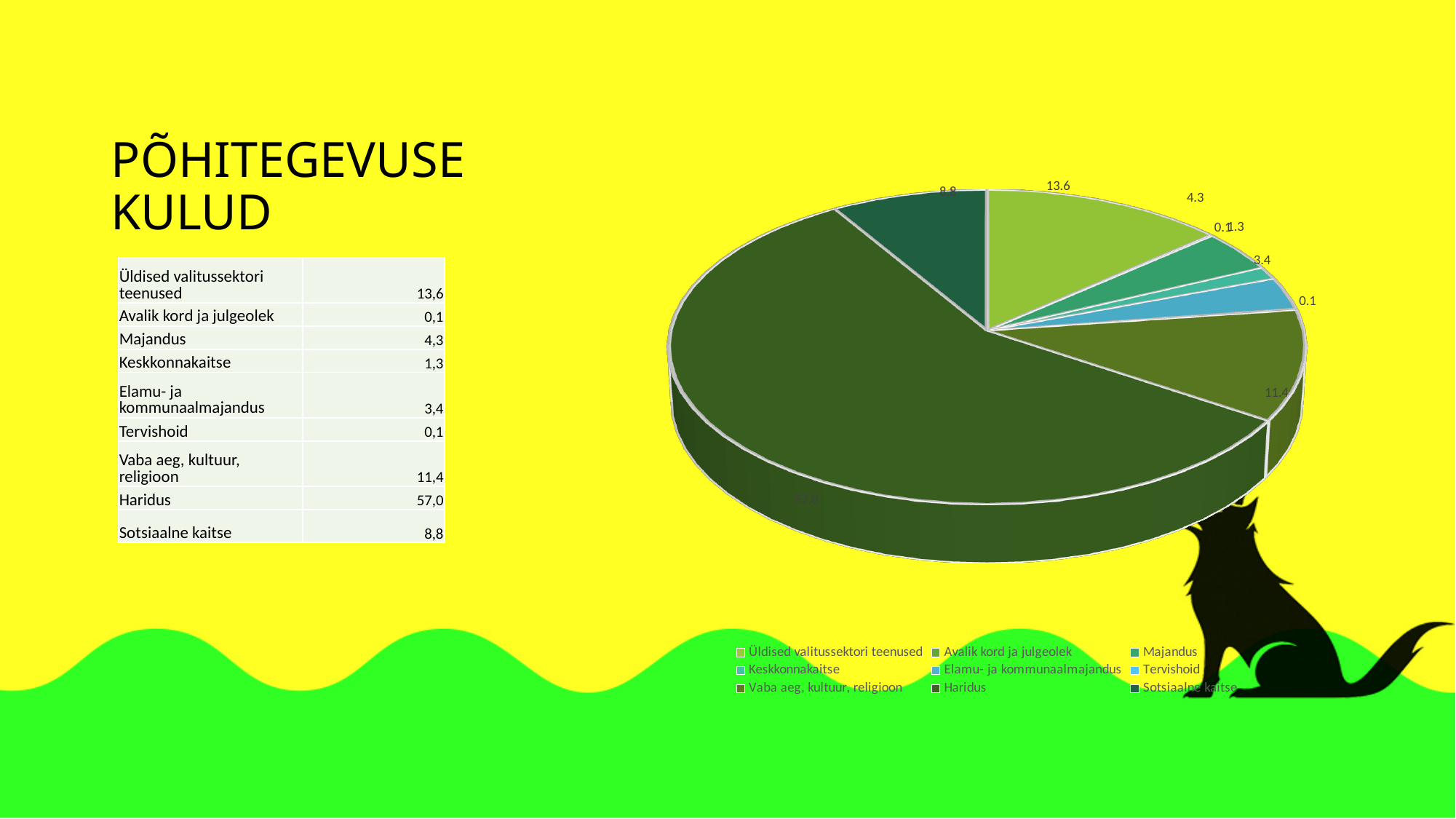
What is the value for Sotsiaalne kaitse in the pie chart? 8.8 What is the value for Majandus in the pie chart? 4.3 What is the value for Keskkonnakaitse in the pie chart? 1.3 Which category has the largest slice in the pie chart? Haridus How many slices does the pie chart have? 9 What is the value for Vaba aeg, kultuur, religioon in the pie chart? 11.4 How many entries does the pie chart's legend list? 9 What kind of chart is shown on the slide? pie chart What is the value for Üldised valitussektori teenused in the pie chart? 13.6 Which is larger in the pie chart, Majandus or Elamu- ja kommunaalmajandus? Majandus What share of the pie does Haridus represent? 57.0% What is the difference between the values for Üldised valitussektori teenused and Sotsiaalne kaitse in the pie chart? 4.8